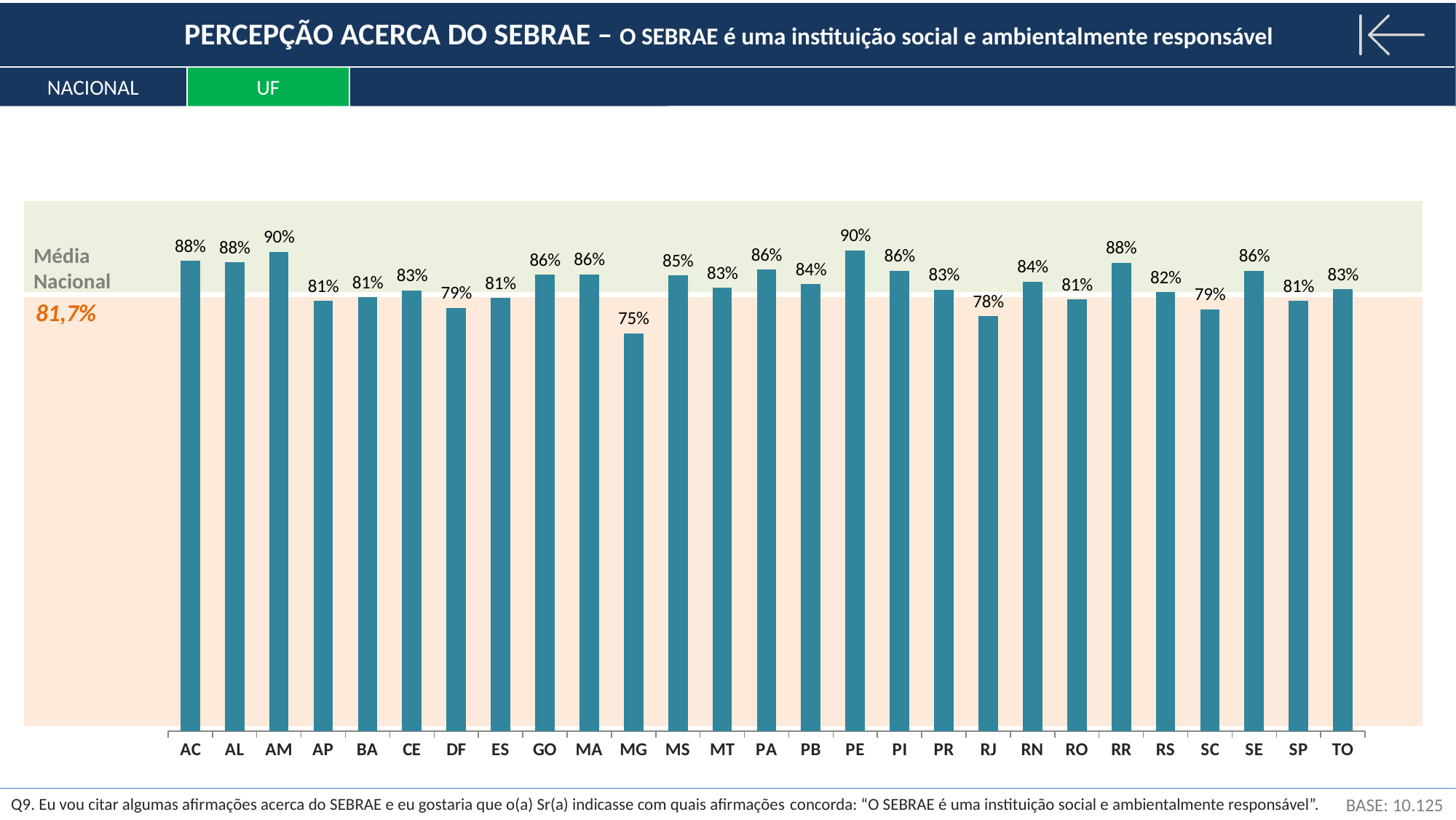
What kind of chart is shown? Bar chart Which states share the highest value? AM and PE What is the difference between the values for RR and RJ? 10% What is the value for RJ? 78% What is the difference between the values for AM and MG? 15% What is the value for MG? 75% How many states are shown on the x axis? 27 What is the value for PE? 90% Which is larger, the value for GO or the value for DF? GO Which state has the lowest value? MG What is the value for RR? 88% What is the Média Nacional value shown on the chart? 81,7%